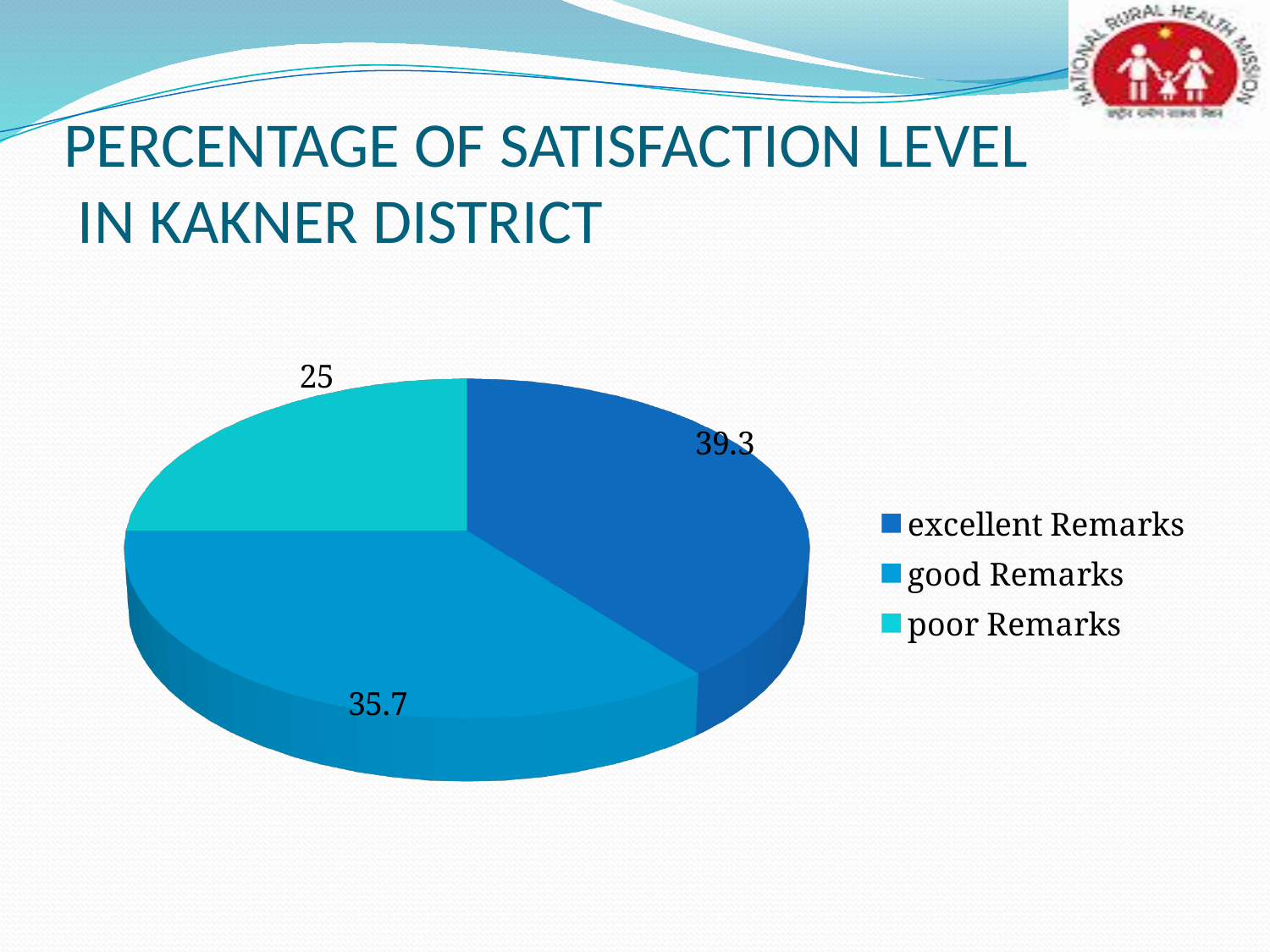
What is the value for poor Remarks? 25 What is the value for excellent Remarks? 39.3 What is the title of the slide containing the chart? PERCENTAGE OF SATISFACTION LEVEL IN KAKNER DISTRICT Which category has the smallest slice? poor Remarks Which is larger, the value for good Remarks or poor Remarks? good Remarks What type of chart is shown on the slide? pie chart What is the difference between the values for good Remarks and poor Remarks? 10.7 How many slices does the pie chart have? 3 Which category has the largest slice? excellent Remarks What is the difference between the values for excellent Remarks and good Remarks? 3.6 How many entries does the legend list? 3 What is the value for good Remarks? 35.7